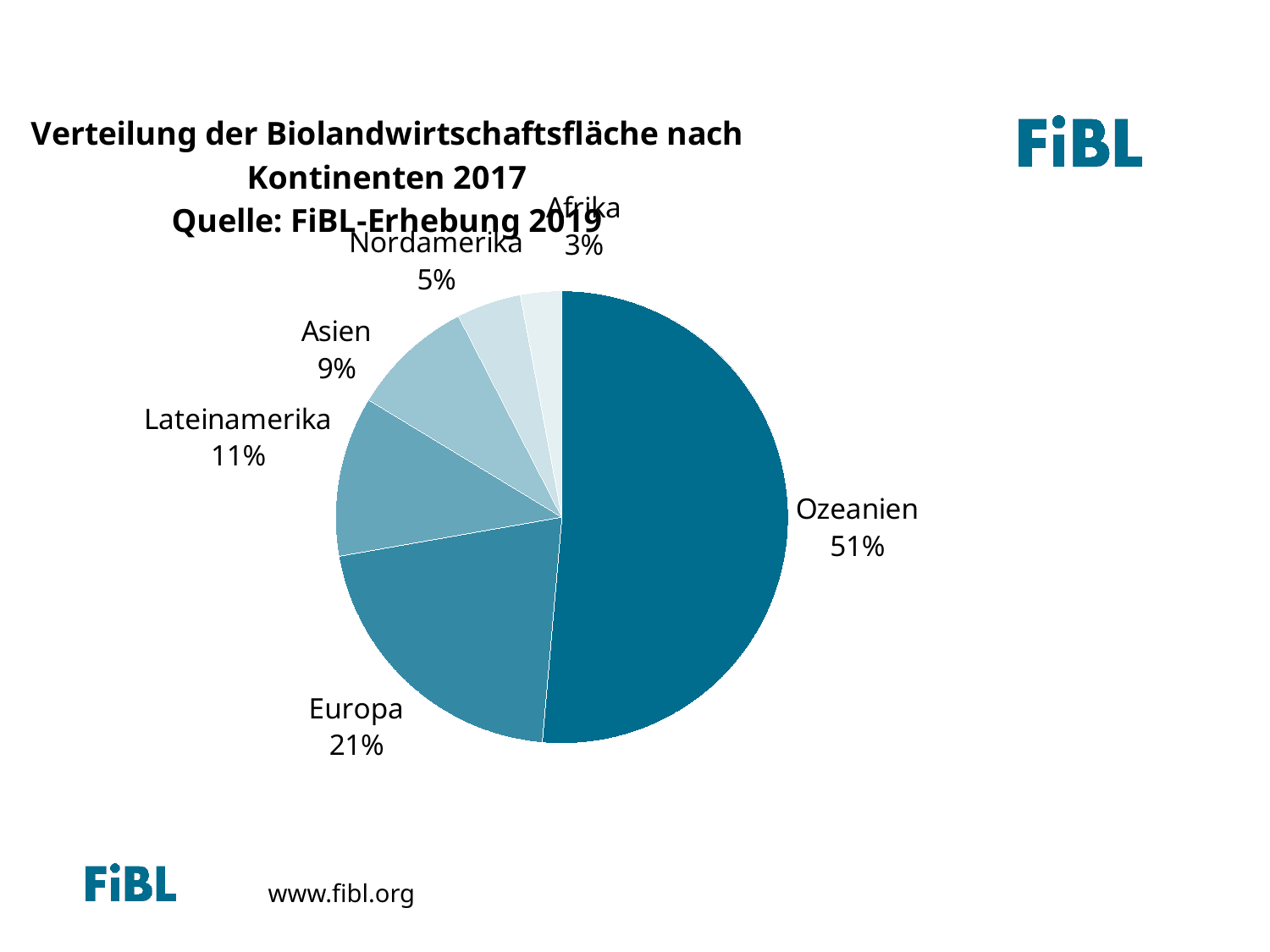
What is the value shown for Asien? 9% Which continent has the largest slice of the pie? Ozeanien What year does the chart title say the data refers to? 2017 What is the value shown for Lateinamerika? 11% What is the difference in percentage points between Ozeanien and Europa? 30 What share of the pie does Ozeanien hold? 51% What is the value shown for Nordamerika? 5% Which is larger, the share for Lateinamerika or the share for Asien? Lateinamerika How many continents are shown in the pie chart? 6 Which continent has the smallest slice of the pie? Afrika What kind of chart is shown on the slide? Pie chart What is the value shown for Europa? 21%